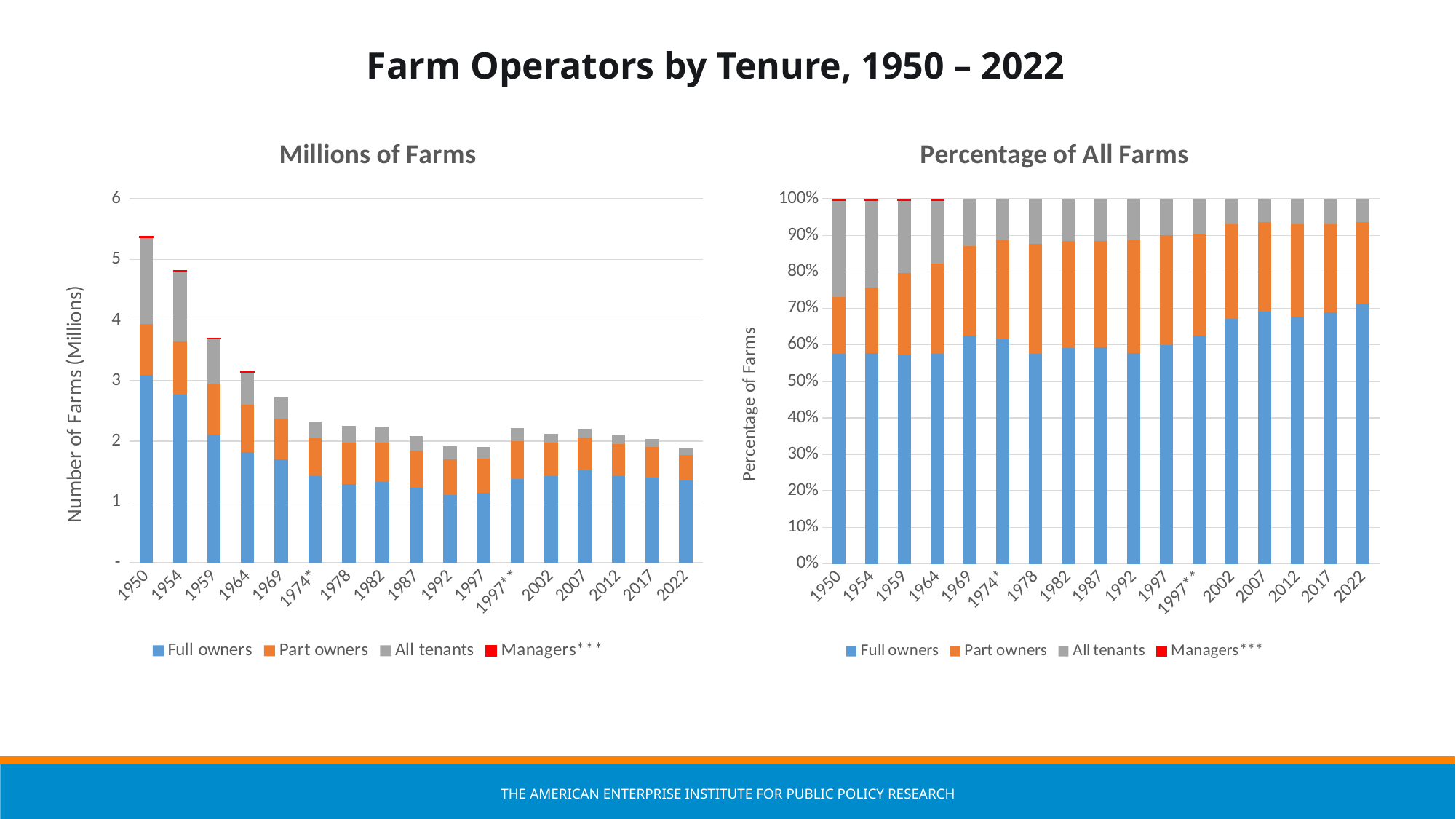
In the "Millions of Farms" chart, is the total number of farms in 1950 greater or less than 5 million? greater In the "Millions of Farms" chart, is the total number of farms in 2022 greater or less than 2 million? less How many year categories are shown on the x axis of the "Millions of Farms" chart? 17 In the "Percentage of All Farms" chart, is the full owners share in 2002 greater or less than 60%? greater What kind of chart is the "Millions of Farms" chart on the left? Stacked bar chart Which series is shown in red in the legends of both charts? Managers*** In the "Millions of Farms" chart, does the total number of farms generally rise or fall from 1950 to 2022? fall In the "Millions of Farms" chart, which is larger: the number of full owners in 1950 or in 1954? 1950 How many series does the legend of the "Percentage of All Farms" chart list? 4 In the "Millions of Farms" chart, which year has the highest total number of farms? 1950